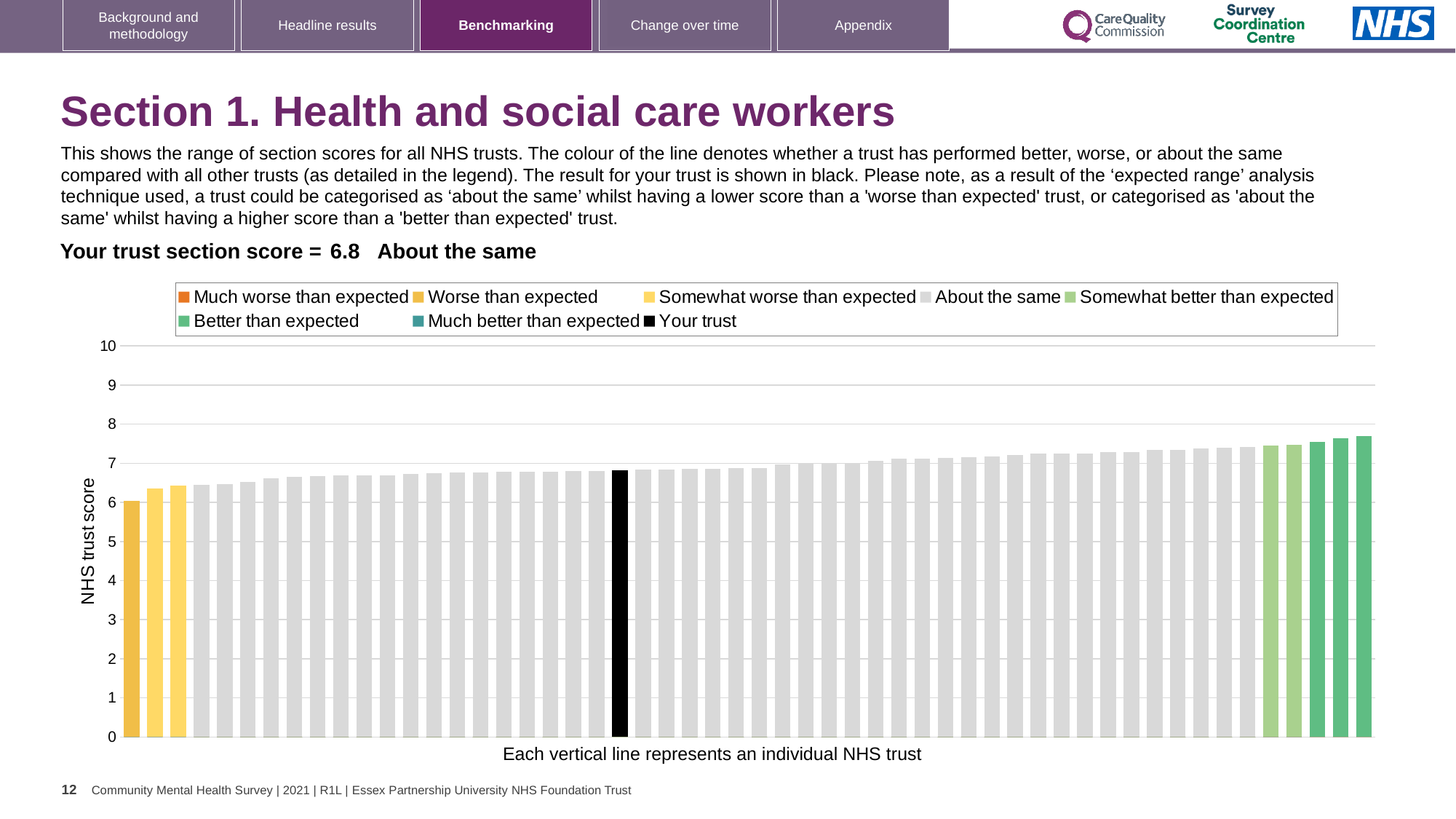
Is the value of the leftmost bar greater or less than 7? less Is the value of the rightmost bar greater or less than 7? greater Is the value of the rightmost bar greater or less than 8? less What is the label on the vertical axis of the chart? NHS trust score What is the section score for your trust shown on the slide? 6.8 How many entries does the chart legend list? 8 How many bars are coloured as 'Worse than expected'? 1 Do the bar values rise or fall from left to right along the x axis? rise Which legend category do the tallest bars on the chart belong to? Better than expected What kind of chart is shown on the slide? bar chart Which is larger: the bar for your trust or the leftmost bar? Your trust Which legend category do the shortest bars on the chart belong to? Worse than expected